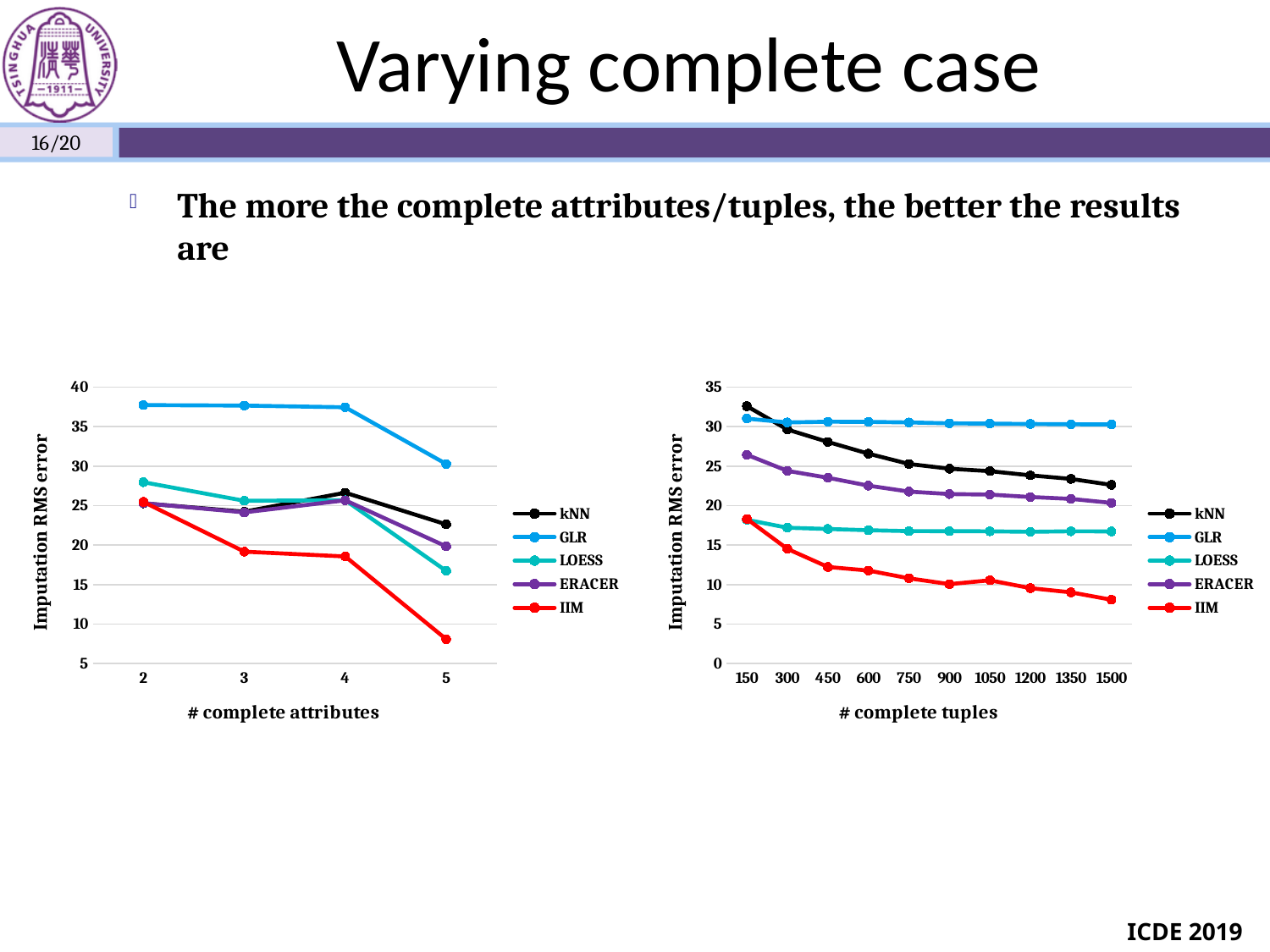
What kind of chart is the left chart (# complete attributes)? line chart How many x-axis points are plotted in the right chart (# complete tuples)? 10 In the left chart (# complete attributes), which series has the lowest error at 5 complete attributes? IIM In the right chart (# complete tuples), is the IIM value at 1500 complete tuples greater or less than 10? less In the right chart (# complete tuples), which is larger at 150 complete tuples: kNN or GLR? kNN What is the y-axis label of the left chart (# complete attributes)? Imputation RMS error In the left chart (# complete attributes), is the GLR value at 3 complete attributes greater or less than 35? greater In the right chart (# complete tuples), does the IIM series generally rise or fall as the number of complete tuples increases? fall In the left chart (# complete attributes), which series has the highest error at 2 complete attributes? GLR How many series does the legend of the right chart (# complete tuples) list? 5 How many x-axis points are plotted in the left chart (# complete attributes)? 4